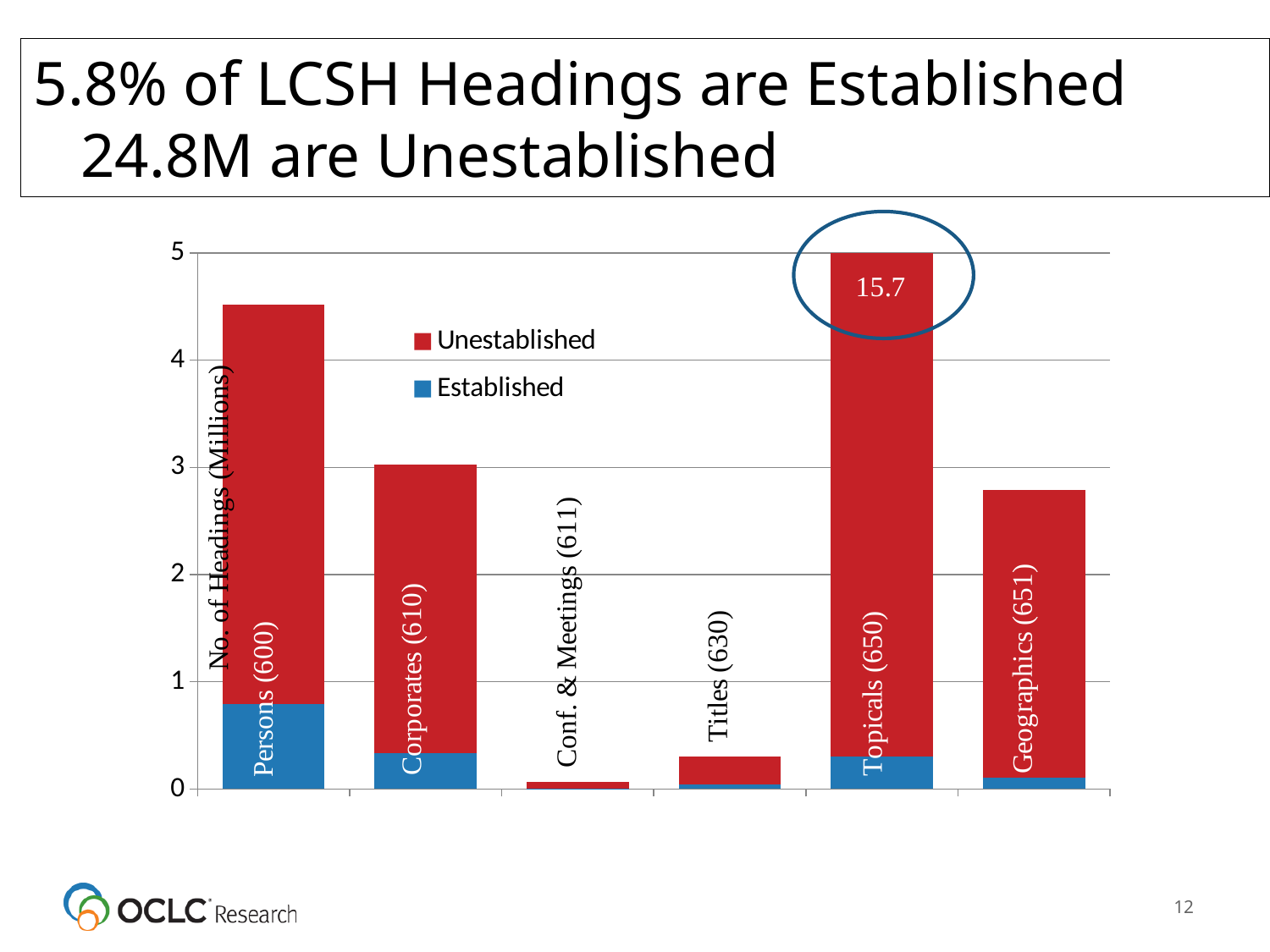
Is the total bar height for Persons (600) greater or less than 4? greater Which bar is taller, Persons (600) or Corporates (610)? Persons (600) What kind of chart is shown on the slide? bar chart Which category has the shortest bar in the chart? Conf. & Meetings (611) Which category has the tallest bar in the chart? Topicals (650) Is the total bar height for Geographics (651) greater or less than 3? less Is the total bar height for Titles (630) greater or less than 1? less What value is printed on the Topicals (650) bar? 15.7 How many categories are shown along the x axis of the chart? 6 Which colour represents the Unestablished series in the chart? red How many series does the chart's legend list? 2 What is the title of the chart's y axis? No. of Headings (Millions)